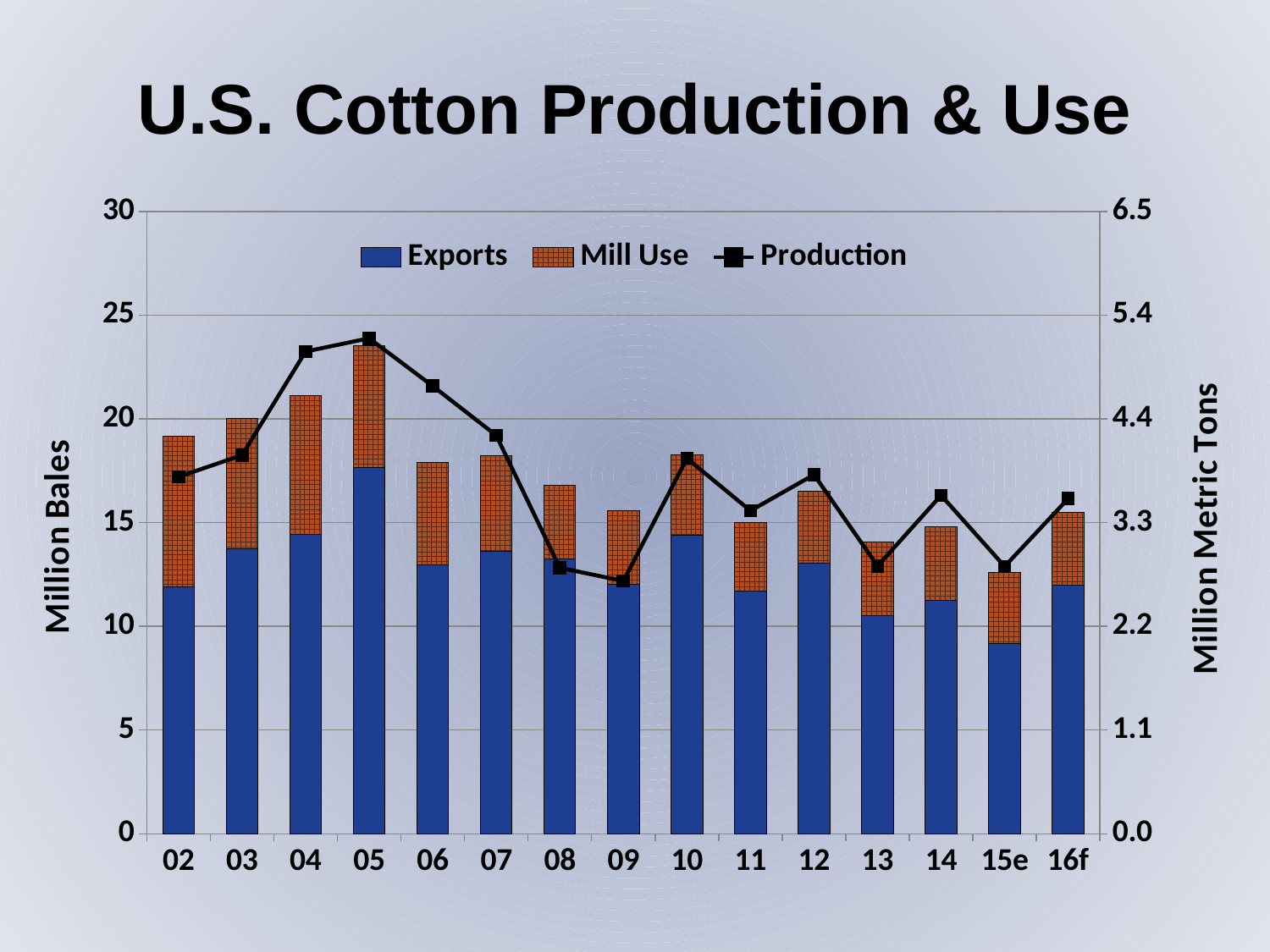
Does the Production line rise or fall from 05 to 09? Fall What is the label on the right-hand vertical axis? Million Metric Tons Is the Exports value for 05 greater or less than 15 million bales? greater Which year has the tallest stacked bar (Exports plus Mill Use)? 05 Is the Production value for 05 greater or less than 4.4 million metric tons? greater Which year has the shortest stacked bar (Exports plus Mill Use)? 15e Which year has the larger total stacked bar, 04 or 06? 04 How many years are shown along the x axis? 15 What kind of chart is shown on the slide? A combined stacked bar and line chart How many series does the legend list? 3 Is the Exports value for 15e greater or less than 10 million bales? less In which year is the Production line at its highest point? 05